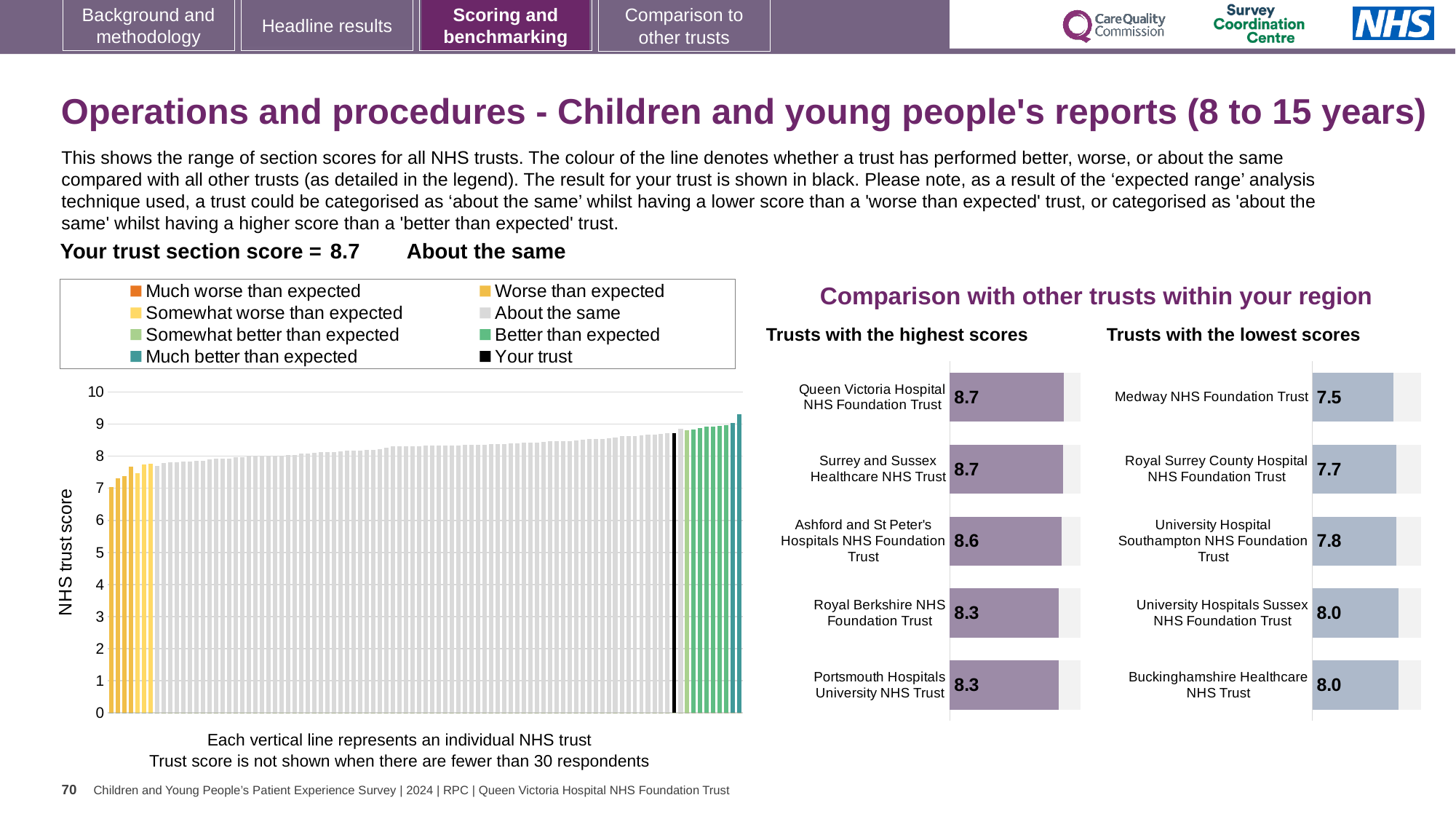
In the 'Trusts with the lowest scores' chart, which trust has the lowest score? Medway NHS Foundation Trust In the 'Trusts with the lowest scores' chart, what is the score for Medway NHS Foundation Trust? 7.5 How many entries does the legend of the large chart on the left list? 8 In the 'Trusts with the highest scores' chart, what is the score for Queen Victoria Hospital NHS Foundation Trust? 8.7 How many trusts are listed in the 'Trusts with the highest scores' chart? 5 What kind of chart is the large chart on the left showing NHS trust scores? Bar chart In the 'Trusts with the lowest scores' chart, which has the higher score: Royal Surrey County Hospital NHS Foundation Trust or Medway NHS Foundation Trust? Royal Surrey County Hospital NHS Foundation Trust In the large chart on the left, do the trust scores rise or fall from left to right? Rise In the 'Trusts with the highest scores' chart, what is the score for Royal Berkshire NHS Foundation Trust? 8.3 In the 'Trusts with the highest scores' chart, what is the difference between the scores of Queen Victoria Hospital NHS Foundation Trust and Portsmouth Hospitals University NHS Trust? 0.4 In the 'Trusts with the lowest scores' chart, what is the difference between the scores of University Hospital Southampton NHS Foundation Trust and Medway NHS Foundation Trust? 0.3 In the large chart on the left, is the value of the black 'Your trust' bar greater or less than 8? greater